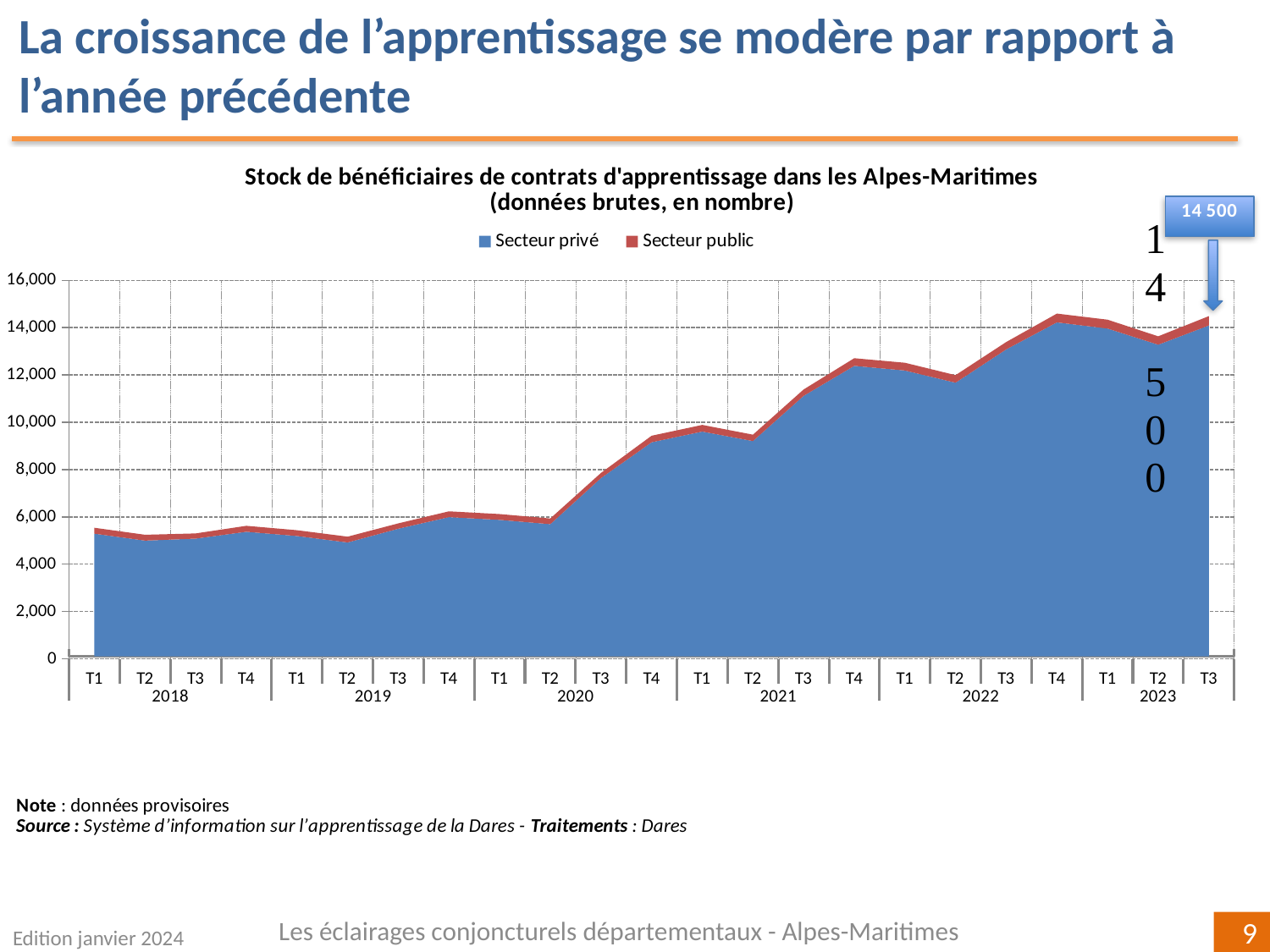
What type of chart is shown on the slide? Area chart Which series is shown in red in the chart? Secteur public Which series is shown in blue in the chart? Secteur privé How many series does the chart legend list? 2 How many quarterly data points are plotted on the chart? 23 Which is larger, the total value for T4 2021 or for T1 2018? T4 2021 Is the total value for T4 2020 greater or less than 8,000? greater Is the total value for T1 2018 greater or less than 6,000? less What is the total stock of apprenticeship beneficiaries shown for T3 2023? 14 500 Does the stock of apprenticeship beneficiaries overall rise or fall from 2018 to 2023? Rise Is the total value for T4 2021 greater or less than 12,000? greater